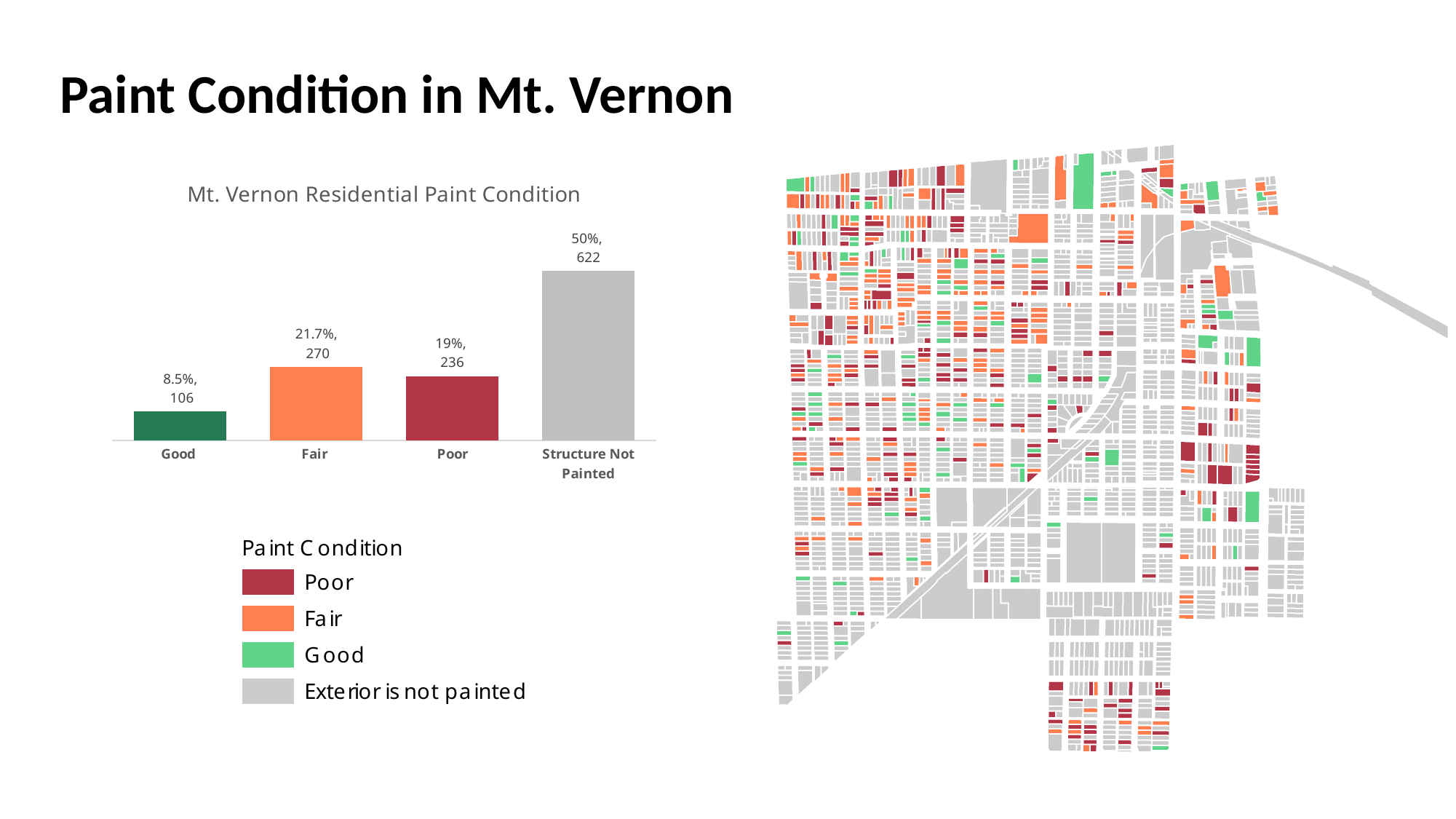
What kind of chart is the Mt. Vernon Residential Paint Condition chart? bar chart Which has a larger count, Fair or Poor? Fair Which category has the lowest count? Good What is the count for the Poor category? 236 What is the difference in count between Fair and Poor? 34 What is the count for the Good category in the Mt. Vernon Residential Paint Condition chart? 106 Which category has the highest count? Structure Not Painted What is the difference in count between Structure Not Painted and Good? 516 What is the title of the chart on the left of the slide? Mt. Vernon Residential Paint Condition How many categories are shown in the bar chart? 4 What percentage is shown for Structure Not Painted? 50% What percentage is shown for the Fair category? 21.7%